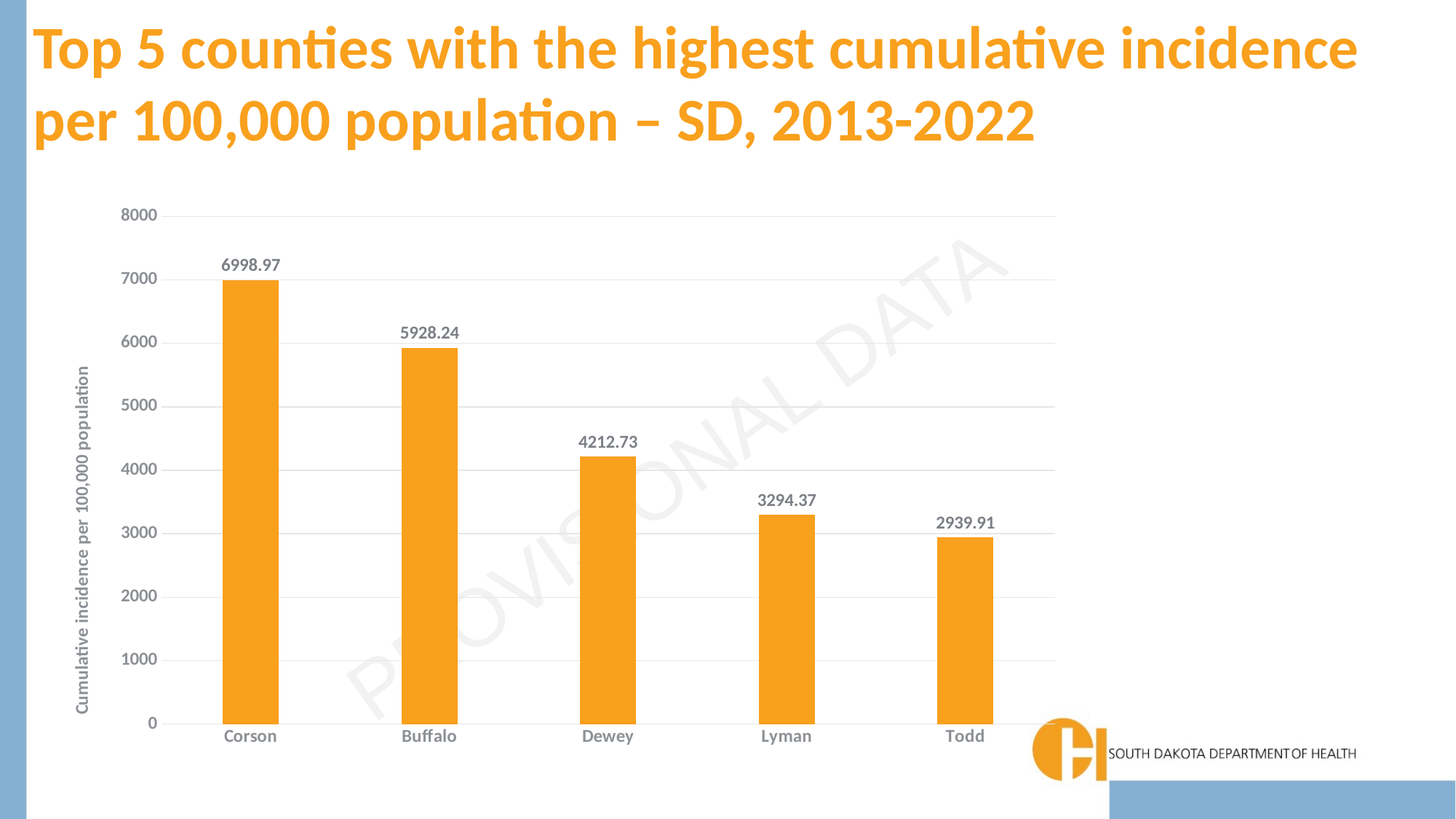
Which county has a higher cumulative incidence, Buffalo or Dewey? Buffalo What is the label of the vertical axis? Cumulative incidence per 100,000 population What is the cumulative incidence per 100,000 population for Corson? 6998.97 What is the difference between the cumulative incidence for Lyman and Todd? 354.46 Is the value for Lyman greater or less than 3000? greater What is the cumulative incidence per 100,000 population for Todd? 2939.91 What kind of chart is shown on the slide? Bar chart What is the difference between the cumulative incidence for Corson and Buffalo? 1070.73 What is the cumulative incidence per 100,000 population for Dewey? 4212.73 Which county has the lowest cumulative incidence per 100,000 population among those shown? Todd Which county has the highest cumulative incidence per 100,000 population? Corson How many counties are shown in the chart? 5